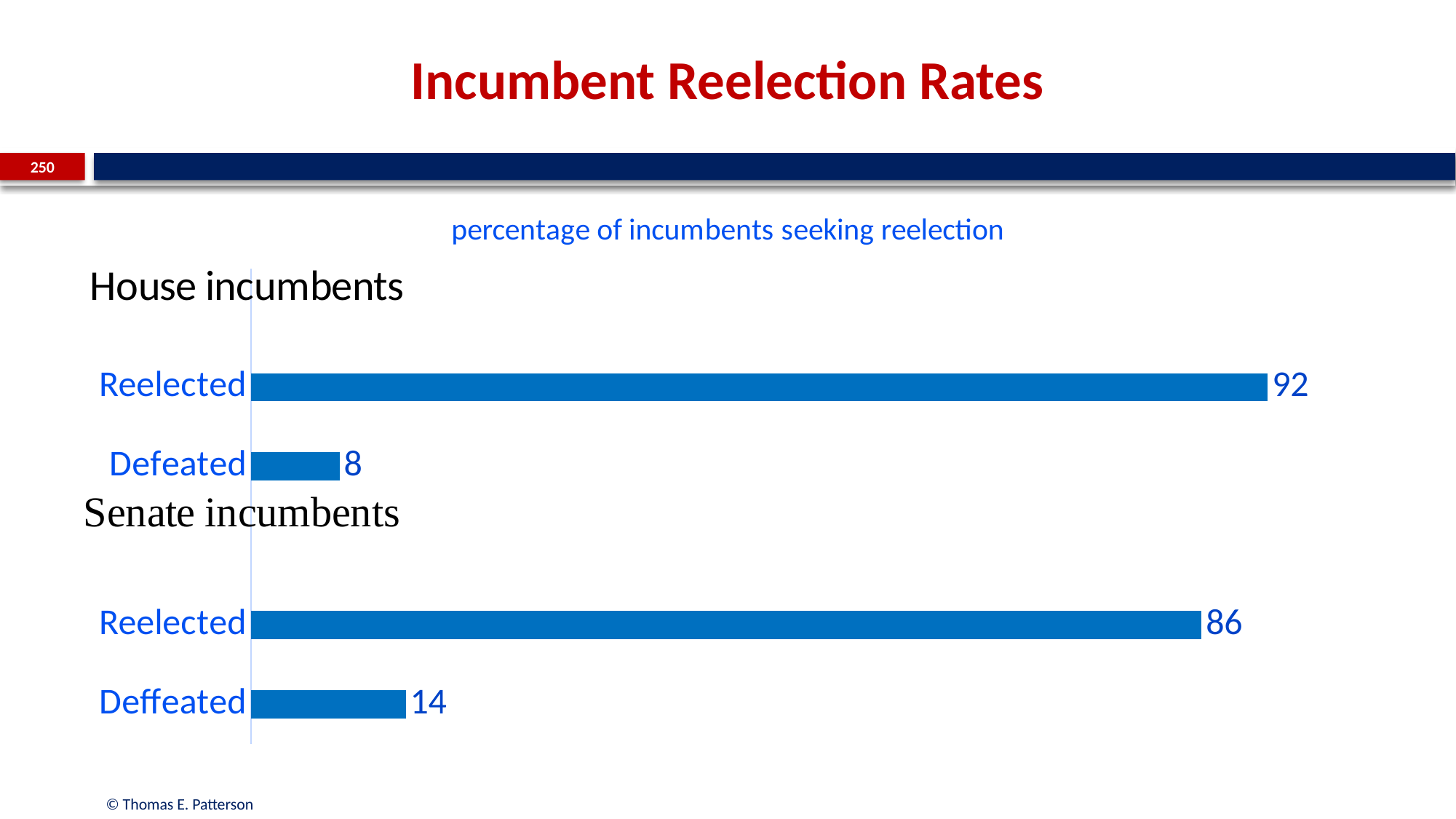
What is the difference between the Senate Deffeated value and the House Defeated value? 6 What is the difference between the House Reelected value and the Senate Reelected value? 6 Which is larger, the Reelected value for House incumbents or the Reelected value for Senate incumbents? House incumbents What is the value for Reelected under House incumbents? 92 What is the value for Reelected under Senate incumbents? 86 What is the subtitle shown above the chart? percentage of incumbents seeking reelection What is the value for Deffeated under Senate incumbents? 14 What is the value for Defeated under House incumbents? 8 Which bar has the lowest value on the chart? House incumbents Defeated Which bar has the highest value on the chart? House incumbents Reelected What kind of chart is shown on the slide? bar chart How many bars are plotted on the chart? 4